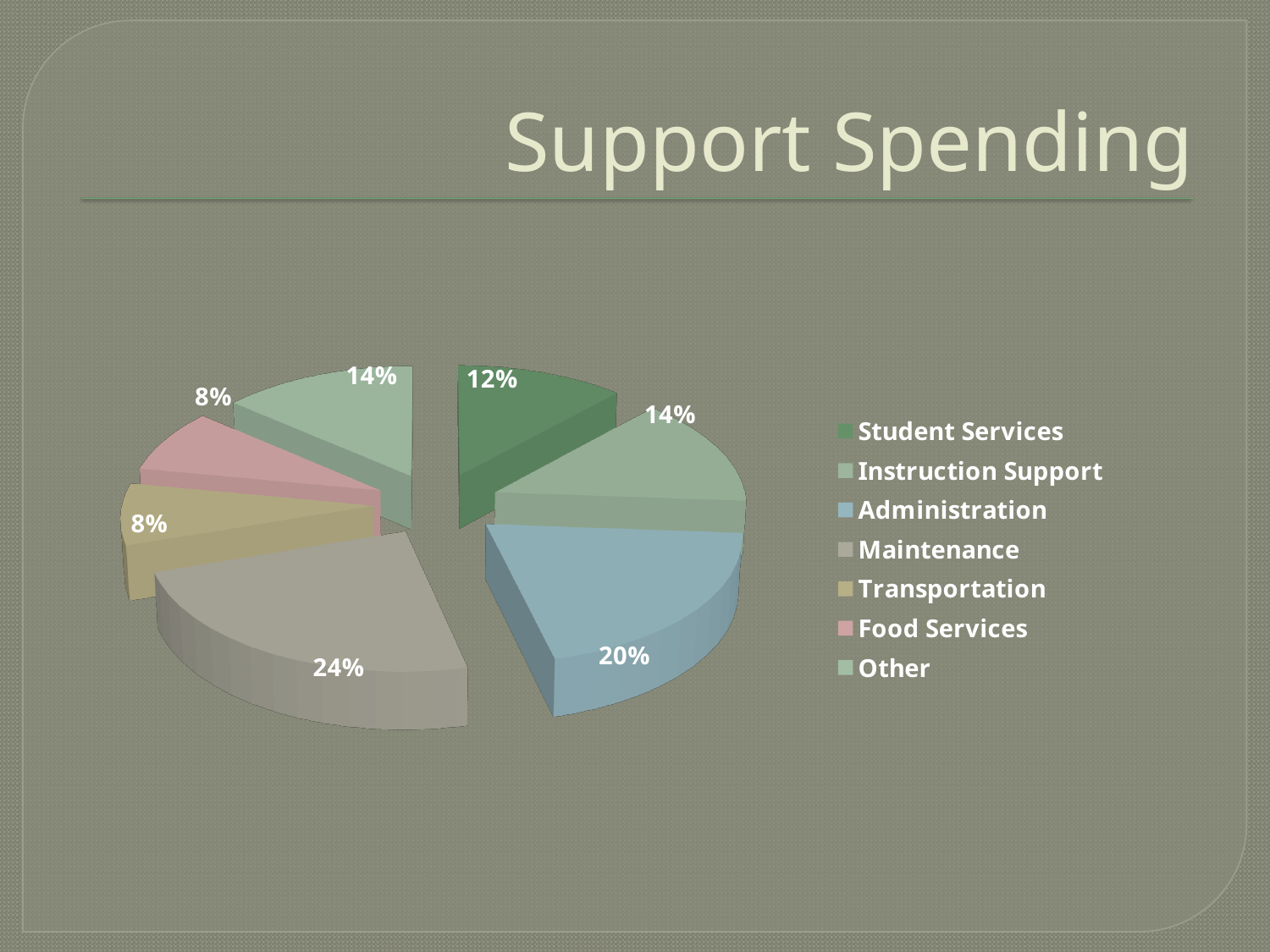
What share of support spending goes to Maintenance? 24% Which is larger, the share for Instruction Support or the share for Student Services? Instruction Support What is the title of the chart? Support Spending What type of chart is shown on the slide? pie chart Which category has the largest share of support spending? Maintenance What share of support spending goes to Transportation? 8% How many categories does the legend list? 7 What is the combined share of Transportation and Food Services? 16% What share of support spending goes to Administration? 20% Which category is shown in blue? Administration What is the difference between the Maintenance share and the Administration share? 4%